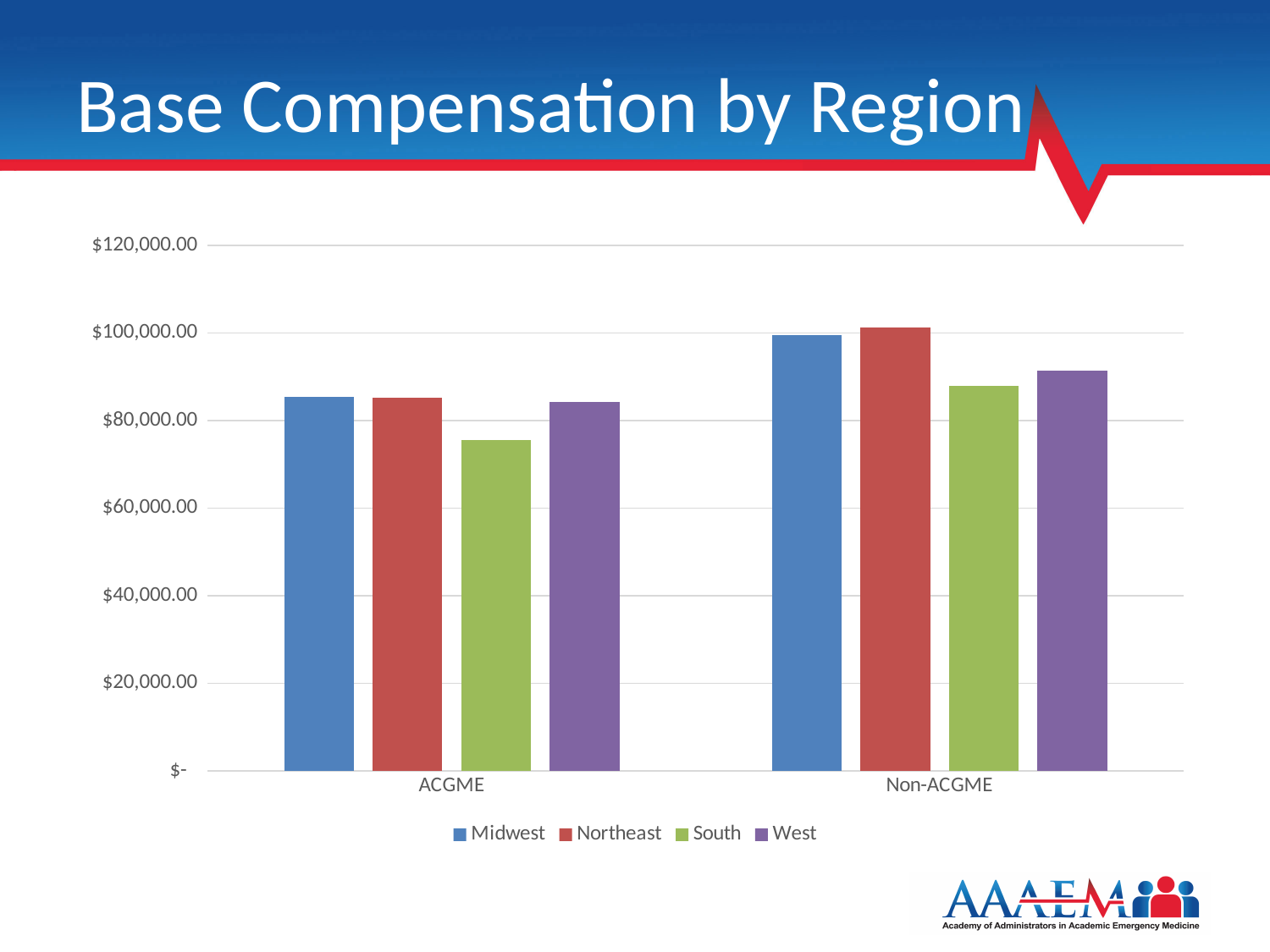
How many series does the legend list? 4 Which region has the highest base compensation in the Non-ACGME category? Northeast How many categories are shown on the x axis? 2 Do the values for each region rise or fall from ACGME to Non-ACGME? rise Which region has the lowest base compensation in the ACGME category? South Is the value for Northeast in the Non-ACGME category greater or less than $100,000.00? greater What kind of chart is shown on the slide? bar chart Which region has the lowest base compensation in the Non-ACGME category? South Is the value for West in the Non-ACGME category greater or less than $100,000.00? less Which is larger, the South value for ACGME or the South value for Non-ACGME? Non-ACGME What is the title of the chart? Base Compensation by Region Is the value for South in the ACGME category greater or less than $80,000.00? less